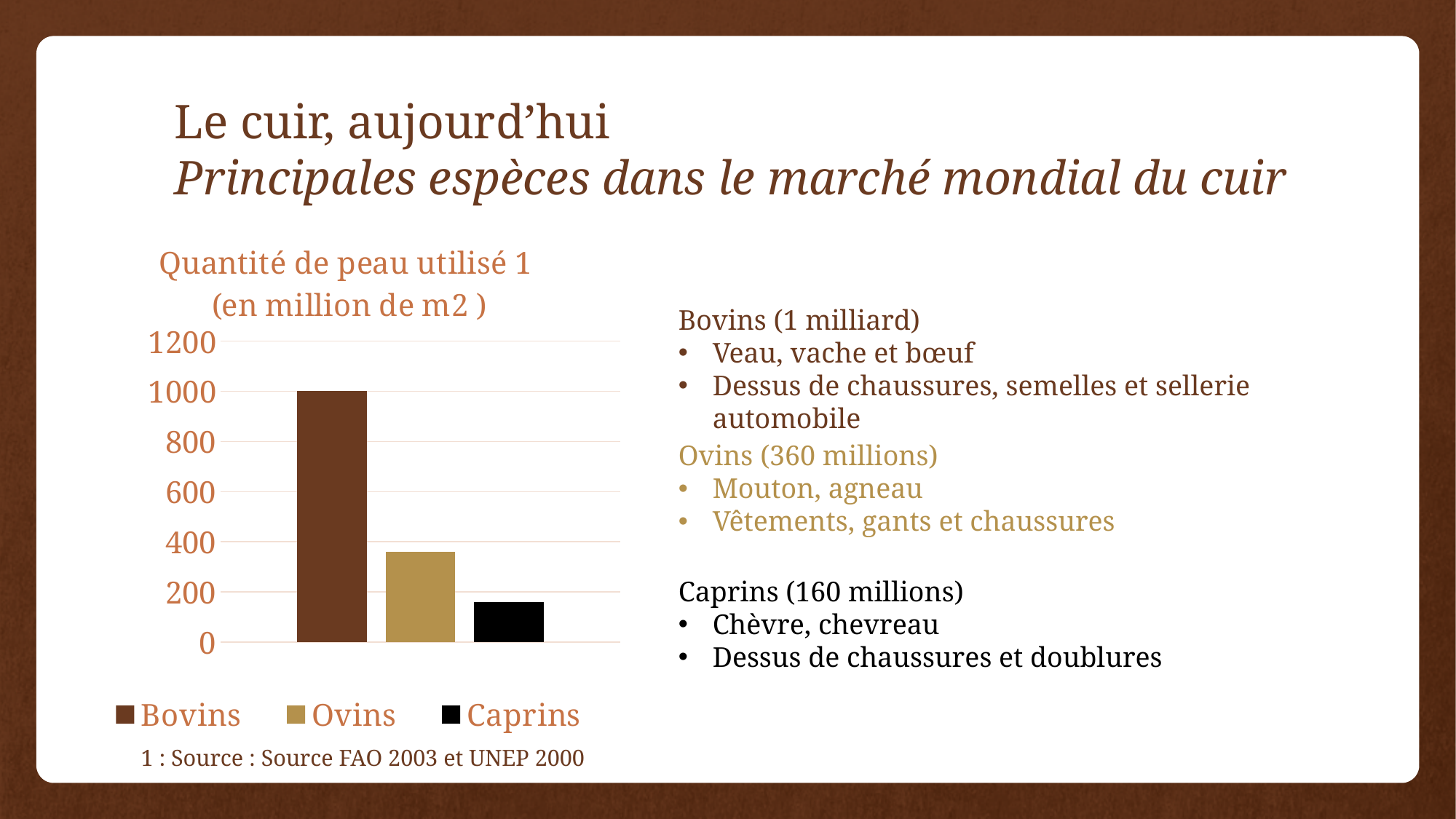
How many series does the chart legend list? 3 Is the value for Caprins greater or less than 200? less Do the bar values rise or fall from left to right across the chart? fall Which category has the lowest value in the chart? Caprins How many bars are plotted in the chart? 3 Which is larger in the chart, the value for Bovins or the value for Ovins? Bovins Which category has the highest value in the chart? Bovins What kind of chart is shown on the slide? bar chart What is the value for Bovins in the chart? 1000 What colour is the Caprins bar in the chart? black Is the value for Ovins greater or less than 200? greater Is the value for Ovins greater or less than 400? less